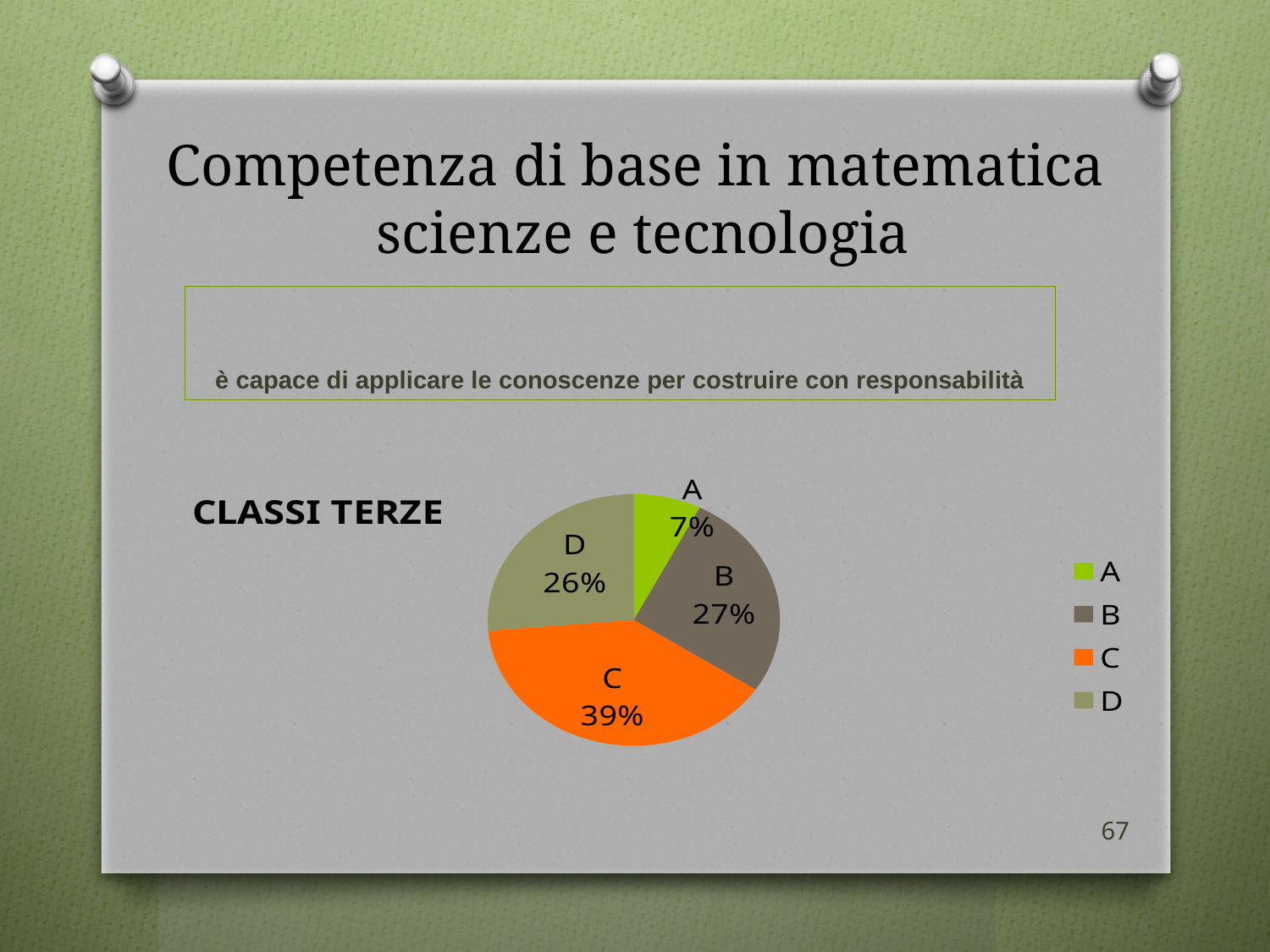
Which slice of the pie chart is the smallest? A What percentage does slice C represent in the pie chart? 39% What is the difference in percentage points between slice C and slice A? 32 What colour is slice C in the pie chart? orange What kind of chart is shown on the slide? pie chart What percentage does slice B represent in the pie chart? 27% Which slice of the pie chart is the largest? C What percentage does slice D represent in the pie chart? 26% Which is larger, slice C or slice D? C What percentage does slice A represent in the pie chart? 7% What is the difference in percentage points between slice B and slice D? 1 How many slices does the pie chart have? 4